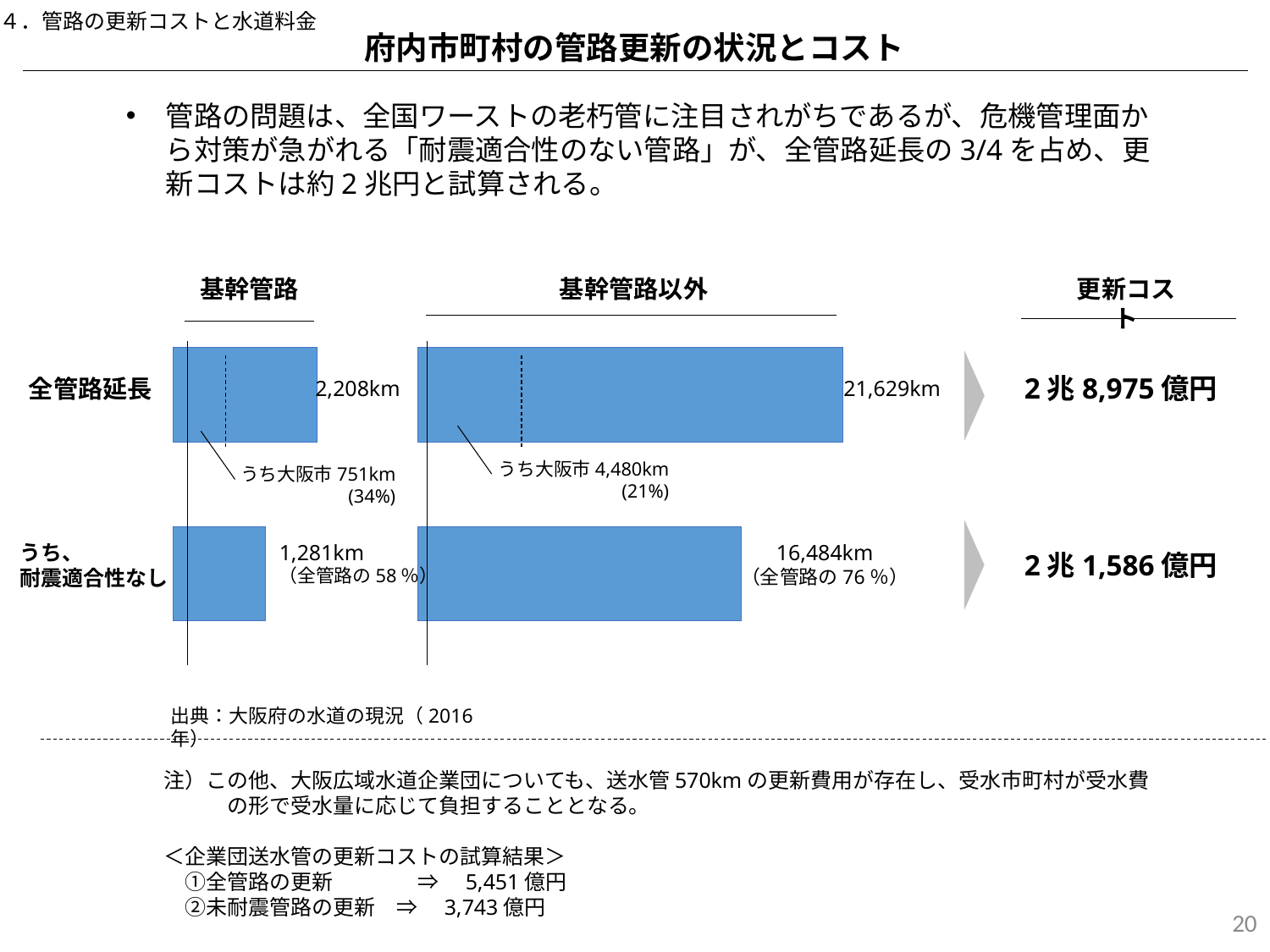
全管路延長の更新コストはいくらですか？ 2兆8,975億円 耐震適合性なしの基幹管路の延長は何kmですか？ 1,281km この図はどの種類のグラフですか？ 棒グラフ 耐震適合性なしの基幹管路以外は全管路の何%を占めますか？ 76% 全管路延長のうち、基幹管路の延長は何kmですか？ 2,208km 耐震適合性なしの管路の更新コストはいくらですか？ 2兆1,586億円 全管路延長において、基幹管路と基幹管路以外ではどちらの延長が長いですか？ 基幹管路以外 耐震適合性なしの基幹管路以外の延長は何kmですか？ 16,484km 基幹管路以外のうち大阪市の延長は何kmですか？ 4,480km 全管路延長の更新コストと耐震適合性なしの更新コストの差はいくらですか？ 7,389億円 基幹管路以外について、全管路延長と耐震適合性なしの延長の差は何kmですか？ 5,145km 全管路延長のうち、基幹管路以外の延長は何kmですか？ 21,629km